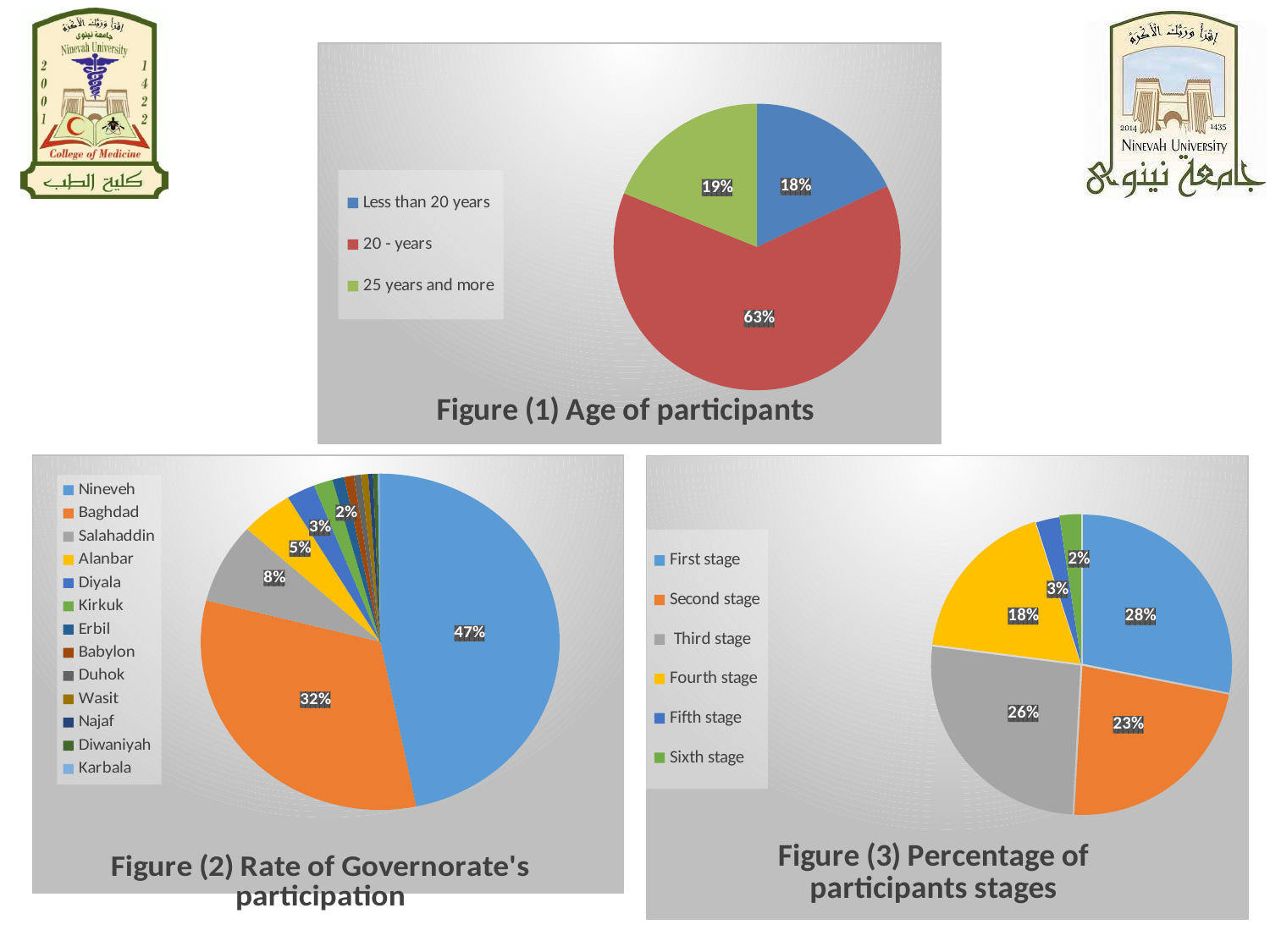
In Figure (2) Rate of Governorate's participation, how many governorates does the legend list? 13 What type of chart is Figure (3) Percentage of participants stages? Pie chart In Figure (2) Rate of Governorate's participation, which is larger, the share for Salahaddin or the share for Alanbar? Salahaddin In Figure (3) Percentage of participants stages, what is the difference in percentage points between the First stage and the Second stage? 5 In Figure (1) Age of participants, what share of participants are 20 - years? 63% In Figure (3) Percentage of participants stages, what share of participants are in the Third stage? 26% In Figure (1) Age of participants, how many categories does the legend list? 3 In Figure (3) Percentage of participants stages, which stage has the largest share? First stage In Figure (2) Rate of Governorate's participation, what share does Nineveh have? 47% In Figure (1) Age of participants, which age group has the smallest share? Less than 20 years In Figure (2) Rate of Governorate's participation, which governorate has the largest share? Nineveh In Figure (1) Age of participants, what is the difference in percentage points between the 20 - years slice and the 25 years and more slice? 44